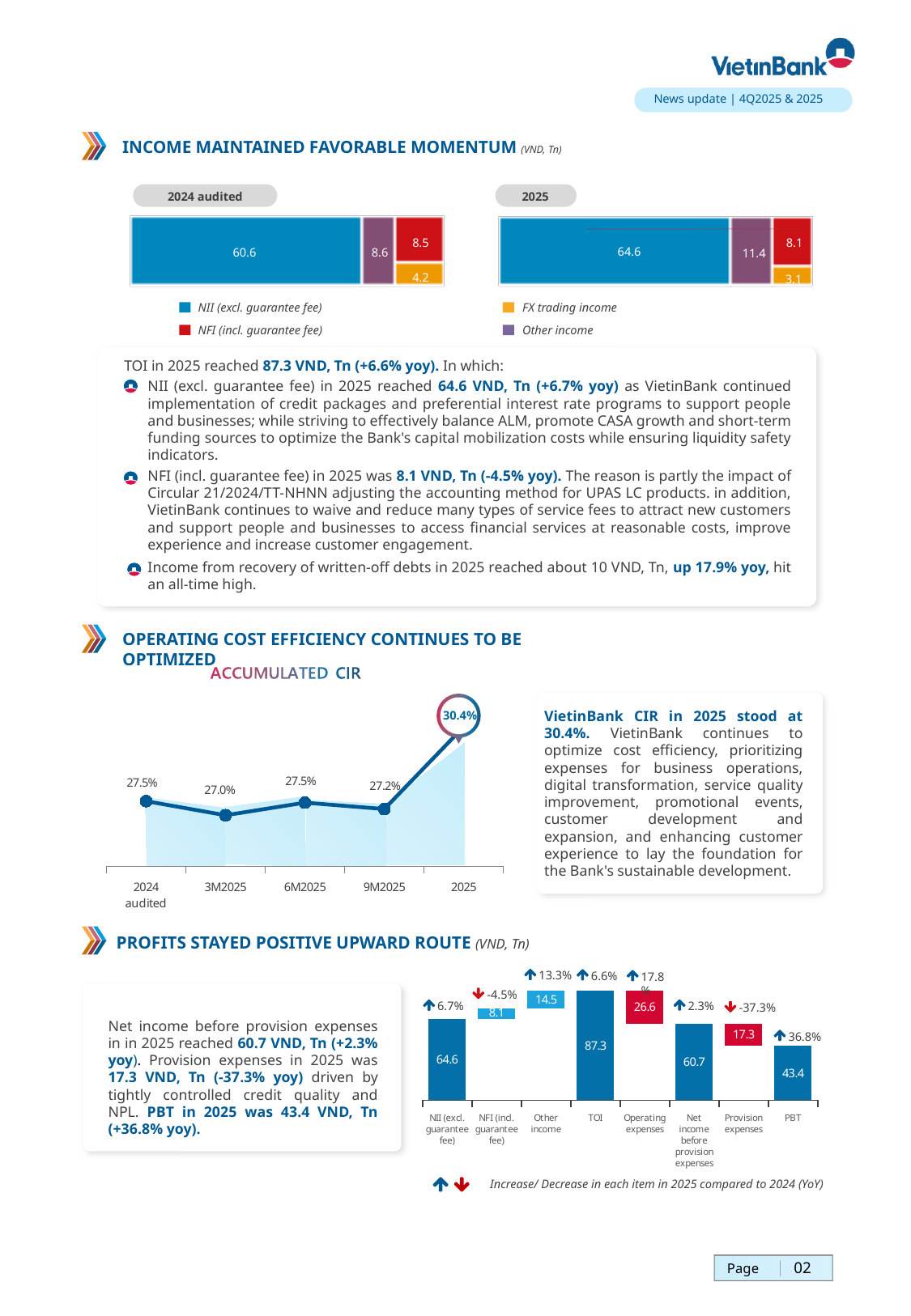
In the 'Income maintained favorable momentum' chart, how many series does the legend list? 4 In the 'Income maintained favorable momentum' chart, what is the NII (excl. guarantee fee) value for 2025? 64.6 In the 'Profits stayed positive upward route' chart, which category has the highest value? TOI In the 'Income maintained favorable momentum' chart, what is the Other income value for 2024 audited? 8.6 In the 'Accumulated CIR' chart, how many data points are plotted? 5 What kind of chart is the 'Profits stayed positive upward route' chart? Bar chart In the 'Income maintained favorable momentum' chart, what is the difference between the FX trading income values for 2024 audited and 2025? 1.1 In the 'Profits stayed positive upward route' chart, what is the difference between TOI and Operating expenses? 60.7 In the 'Accumulated CIR' chart, which period has the highest CIR? 2025 In the 'Profits stayed positive upward route' chart, what is the value for TOI? 87.3 In the 'Accumulated CIR' chart, which period has the lowest CIR? 3M2025 In the 'Accumulated CIR' chart, what is the value for 9M2025? 27.2%